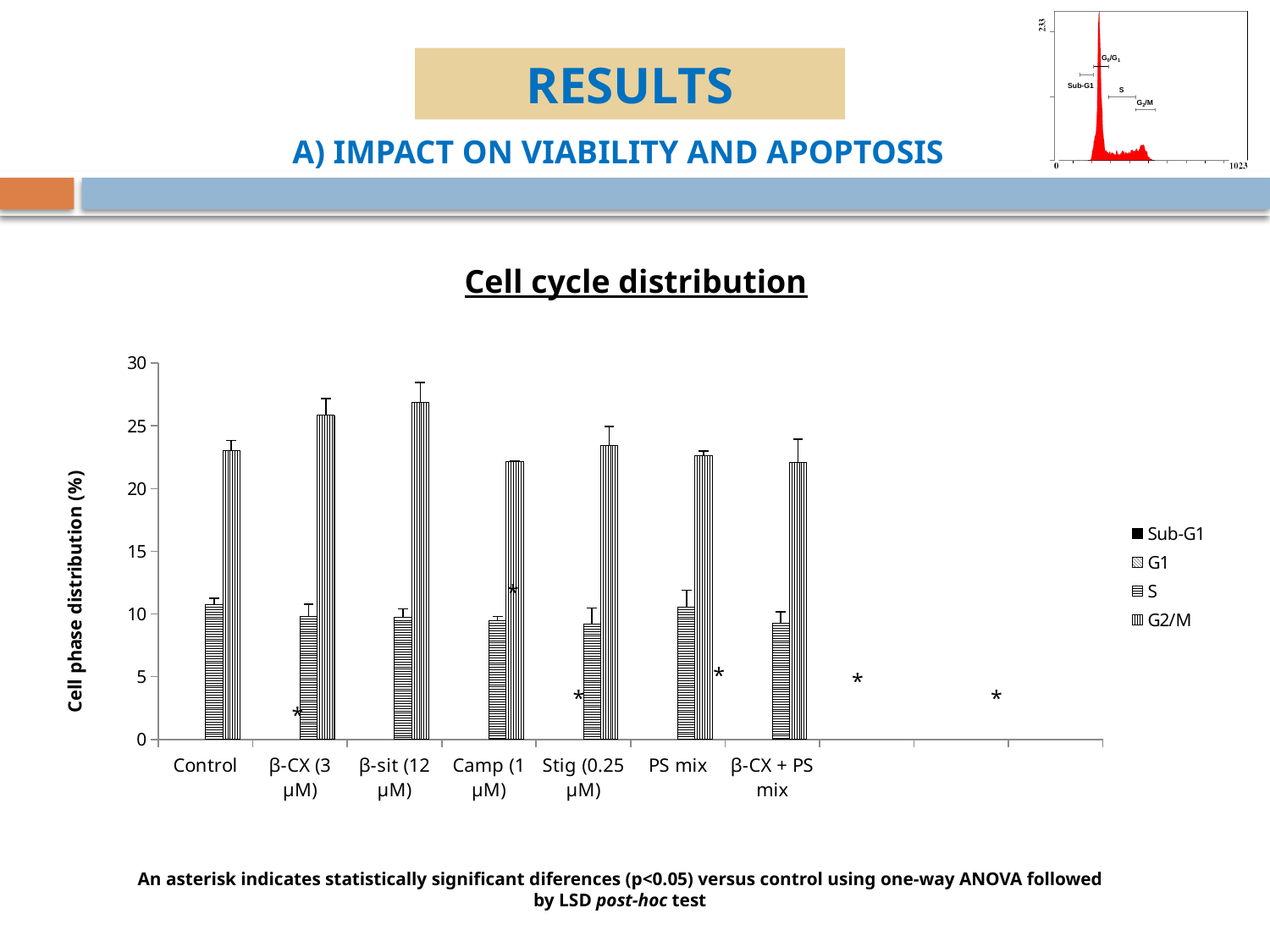
Is the G2/M value for Control greater or less than 20? greater Which is larger for Control, the S value or the G2/M value? G2/M Is the S value for Stig (0.25 µM) greater or less than 15? less Which has the larger G2/M value, Control or β-CX (3 µM)? β-CX (3 µM) What is the label of the y axis of the cell cycle distribution chart? Cell phase distribution (%) Is the G2/M value for Camp (1 µM) greater or less than 25? less How many treatment categories are shown on the x axis of the cell cycle distribution chart? 7 What kind of chart is used to show the cell cycle distribution? Bar chart How many series does the legend of the cell cycle distribution chart list? 4 What is the title of the chart on the slide? Cell cycle distribution